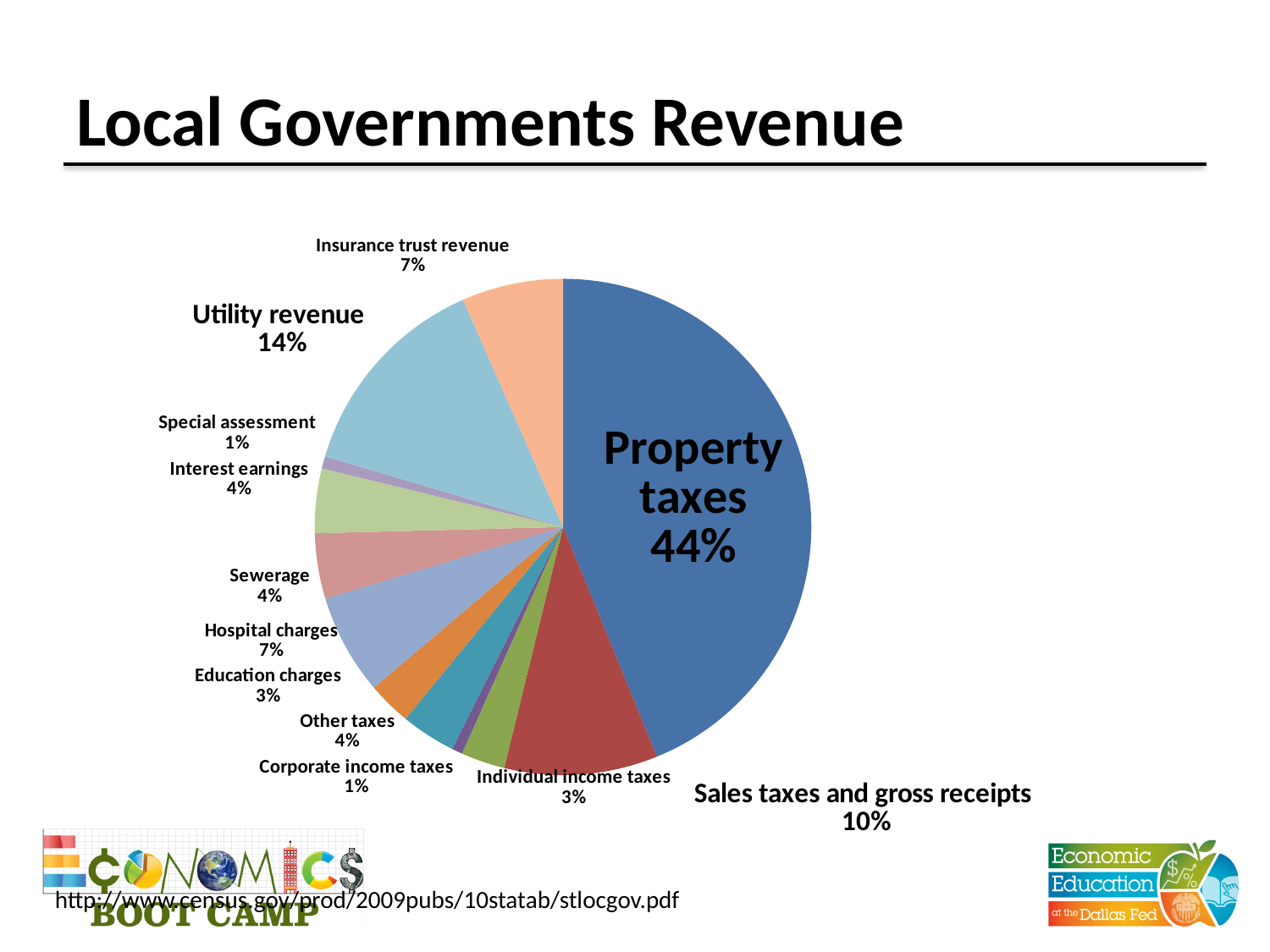
What is the difference in percentage points between Utility revenue and Hospital charges? 7 What is the difference in percentage points between Property taxes and Sales taxes and gross receipts? 34 How many revenue categories are shown in the pie chart? 12 What percentage is shown for Sales taxes and gross receipts? 10% What percentage is shown for Education charges? 3% What type of chart is shown on the slide? pie chart What percentage is shown for Utility revenue? 14% What percentage is shown for Hospital charges? 7% Which revenue source has the largest share of the pie? Property taxes What is the title of the slide containing the pie chart? Local Governments Revenue Which is larger, Utility revenue or Insurance trust revenue? Utility revenue What share of local governments revenue comes from Property taxes? 44%